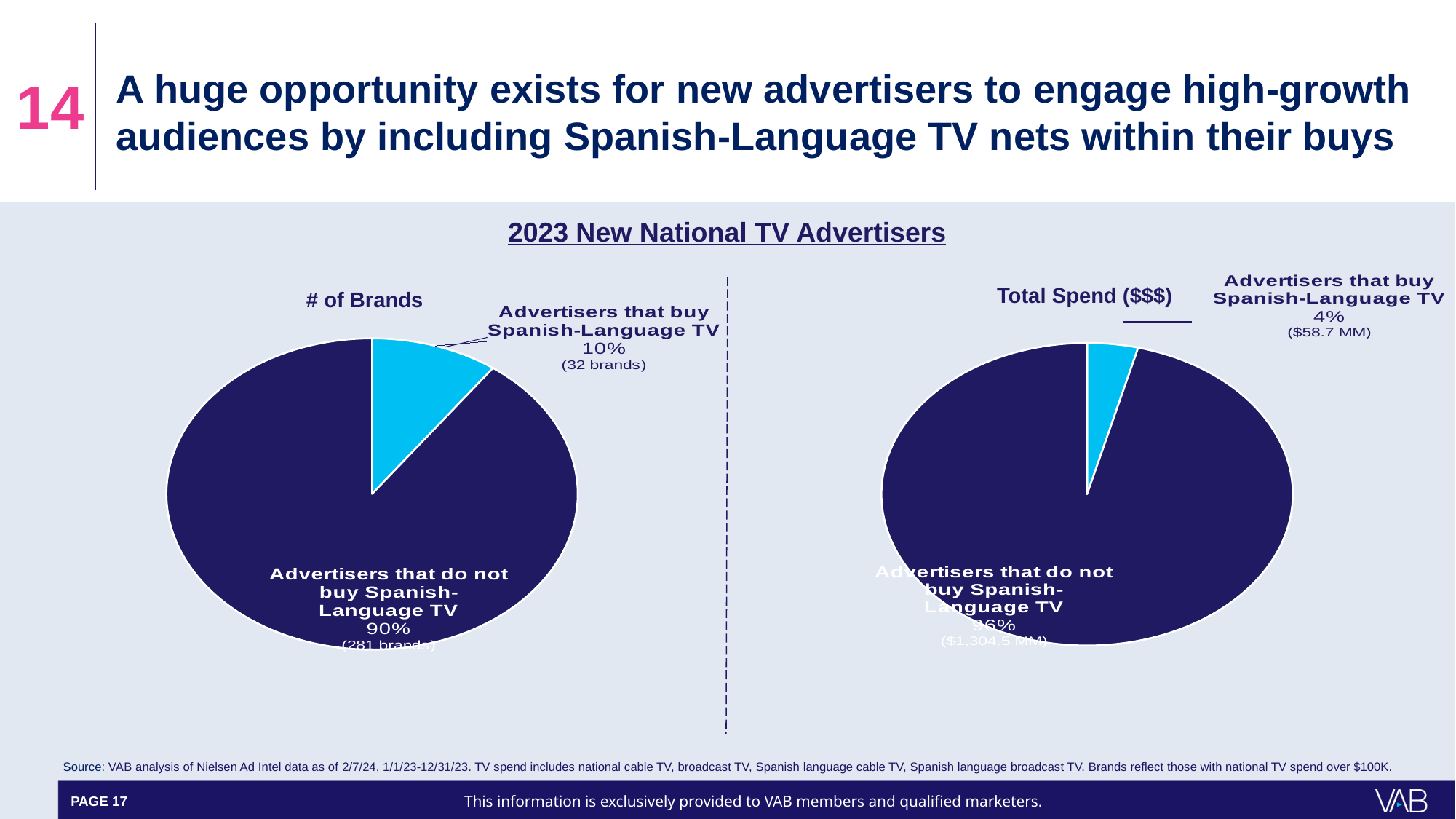
In the 'Total Spend ($$$)' chart, what is the spend of advertisers that do not buy Spanish-Language TV? $1,304.5 MM In the 'Total Spend ($$$)' chart, which slice is the smallest? Advertisers that buy Spanish-Language TV What is the overall title above the two pie charts? 2023 New National TV Advertisers In the '# of Brands' chart, which slice is the largest? Advertisers that do not buy Spanish-Language TV In the '# of Brands' chart, how many brands do not buy Spanish-Language TV? 281 brands In the '# of Brands' chart, what share of advertisers buy Spanish-Language TV? 10% In the '# of Brands' chart, how many brands buy Spanish-Language TV? 32 brands In the 'Total Spend ($$$)' chart, what share of spend comes from advertisers that buy Spanish-Language TV? 4% What kind of chart is the '# of Brands' chart? Pie chart In the 'Total Spend ($$$)' chart, what is the spend of advertisers that buy Spanish-Language TV? $58.7 MM How many slices does the 'Total Spend ($$$)' pie chart have? 2 In the '# of Brands' chart, what is the difference in percentage points between advertisers that do not buy and those that buy Spanish-Language TV? 80 percentage points